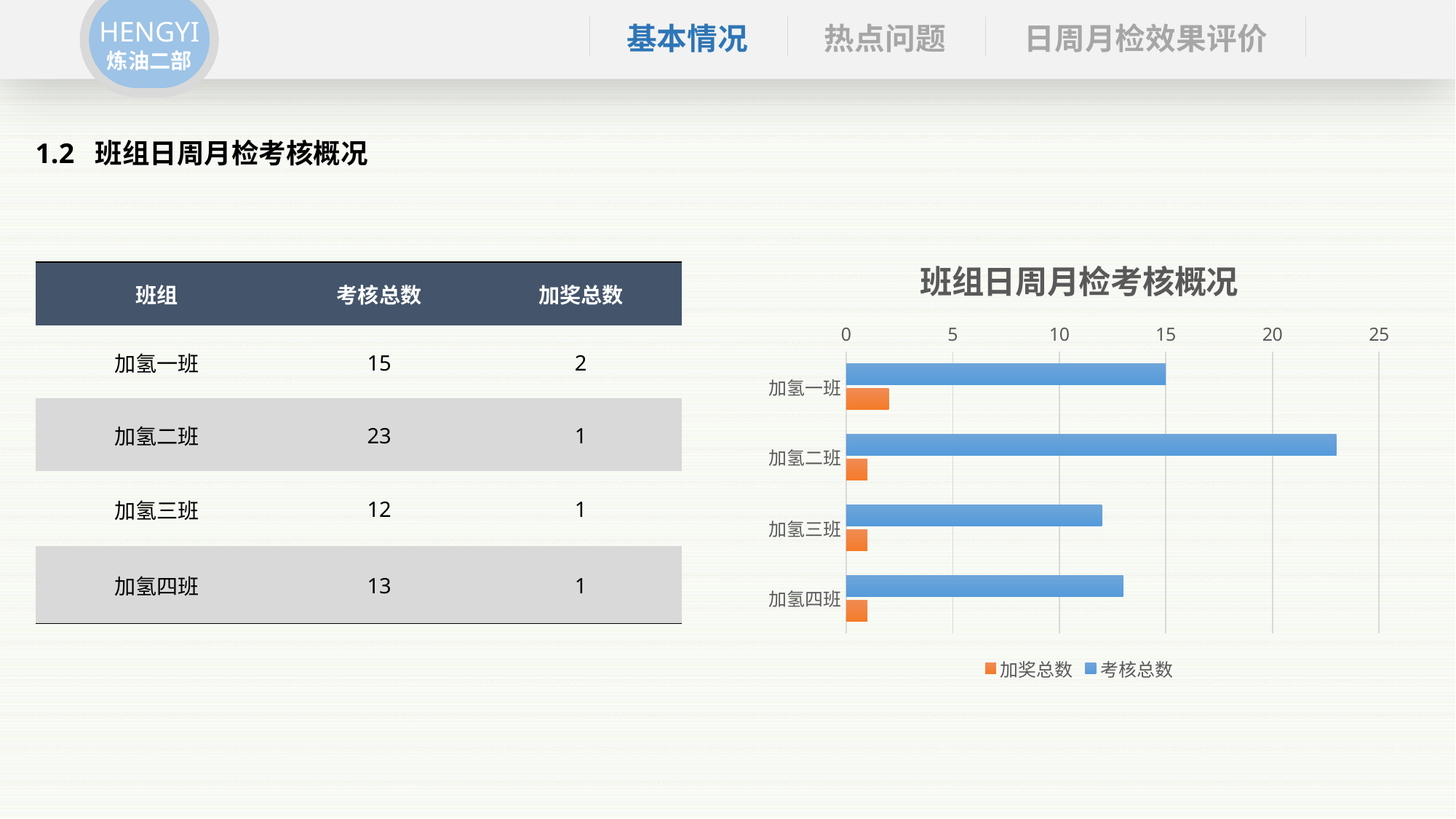
Which has a larger 考核总数, 加氢三班 or 加氢四班? 加氢四班 Which 班组 has the highest 考核总数? 加氢二班 What is the 考核总数 value for 加氢二班? 23 Which 班组 has the lowest 考核总数? 加氢三班 What type of chart is shown on the slide? bar chart What is the difference in 考核总数 between 加氢二班 and 加氢一班? 8 What is the chart's title? 班组日周月检考核概况 How many series does the chart legend list? 2 How many 班组 categories are plotted in the chart? 4 Is the 考核总数 value for 加氢二班 greater or less than 20? greater What is the 加奖总数 value for 加氢一班? 2 Which colour represents the 加奖总数 series in the chart? orange